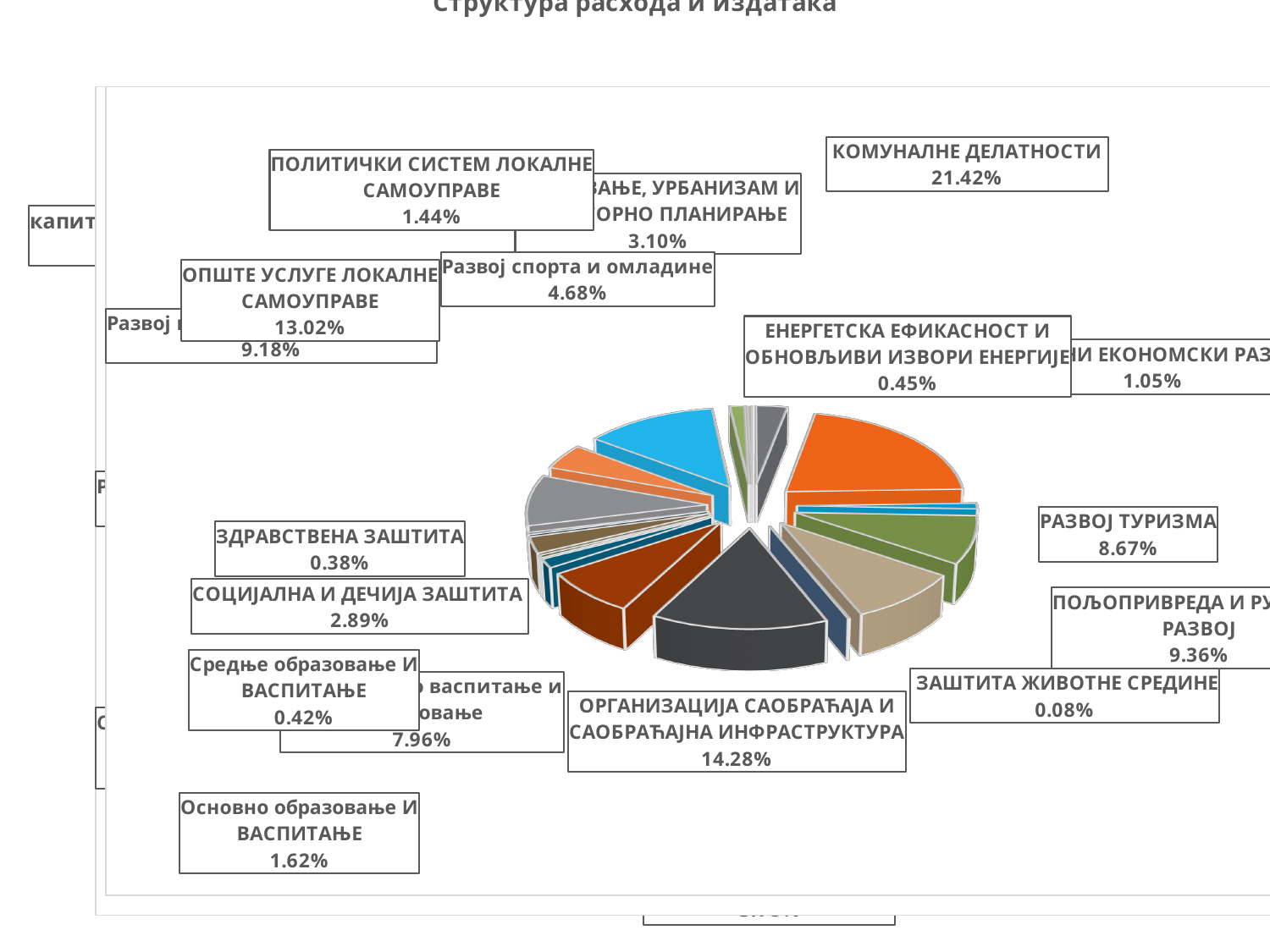
By how many percentage points does КОМУНАЛНЕ ДЕЛАТНОСТИ exceed ОРГАНИЗАЦИЈА САОБРАЋАЈА И САОБРАЋАЈНА ИНФРАСТРУКТУРА? 7.14 percentage points Which category has the smallest share of the pie? ЗАШТИТА ЖИВОТНЕ СРЕДИНЕ What kind of chart is shown on the slide? Pie chart Which is larger: Основно образовање И ВАСПИТАЊЕ or Средње образовање И ВАСПИТАЊЕ? Основно образовање И ВАСПИТАЊЕ What is the value for ЗДРАВСТВЕНА ЗАШТИТА? 0.38% What share of the pie does КОМУНАЛНЕ ДЕЛАТНОСТИ have? 21.42% Which category has the largest share of the pie? КОМУНАЛНЕ ДЕЛАТНОСТИ What percentage is labelled for ОПШТЕ УСЛУГЕ ЛОКАЛНЕ САМОУПРАВЕ? 13.02% What is the value for РАЗВОЈ ТУРИЗМА? 8.67% What share is shown for Развој спорта и омладине? 4.68% Which is larger: Развој спорта и омладине or СОЦИЈАЛНА И ДЕЧИЈА ЗАШТИТА? Развој спорта и омладине What is the value shown for ОРГАНИЗАЦИЈА САОБРАЋАЈА И САОБРАЋАЈНА ИНФРАСТРУКТУРА? 14.28%